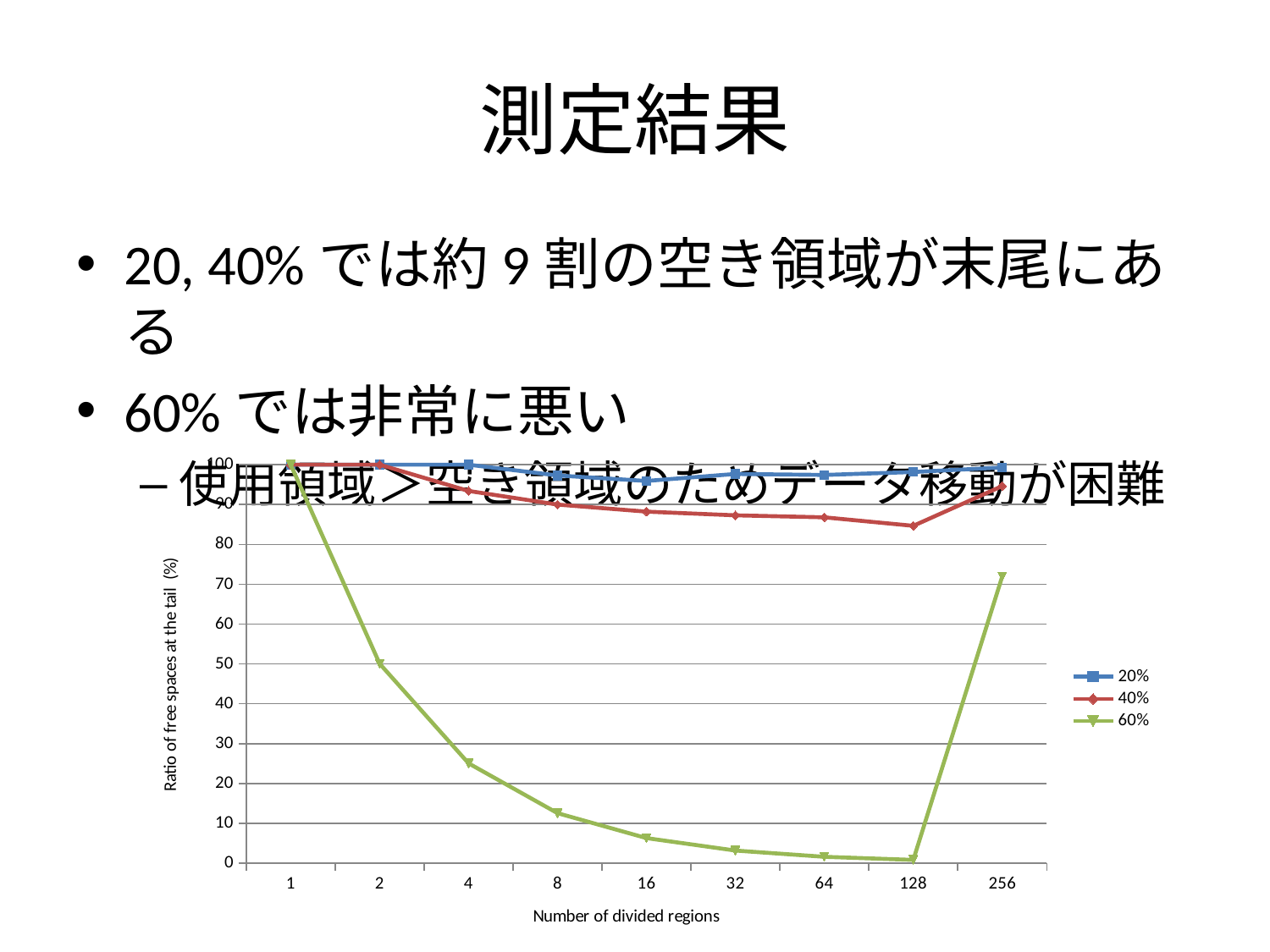
Is the value of the 60% series at 4 divided regions greater or less than 20? greater Is the value of the 40% series at 128 divided regions greater or less than 90? less Does the 60% series rise or fall as the number of divided regions goes from 1 to 128? fall What kind of chart is shown on the slide? line chart At 64 divided regions, which series has the larger value, 20% or 60%? 20% Is the value of the 60% series at 256 divided regions greater or less than 60? greater How many series does the legend list? 3 Which series has the lowest value at 32 divided regions? 60% At which number of divided regions does the 60% series reach its lowest value? 128 What is the title of the x axis? Number of divided regions How many points along the x axis (number of divided regions) are plotted for each series? 9